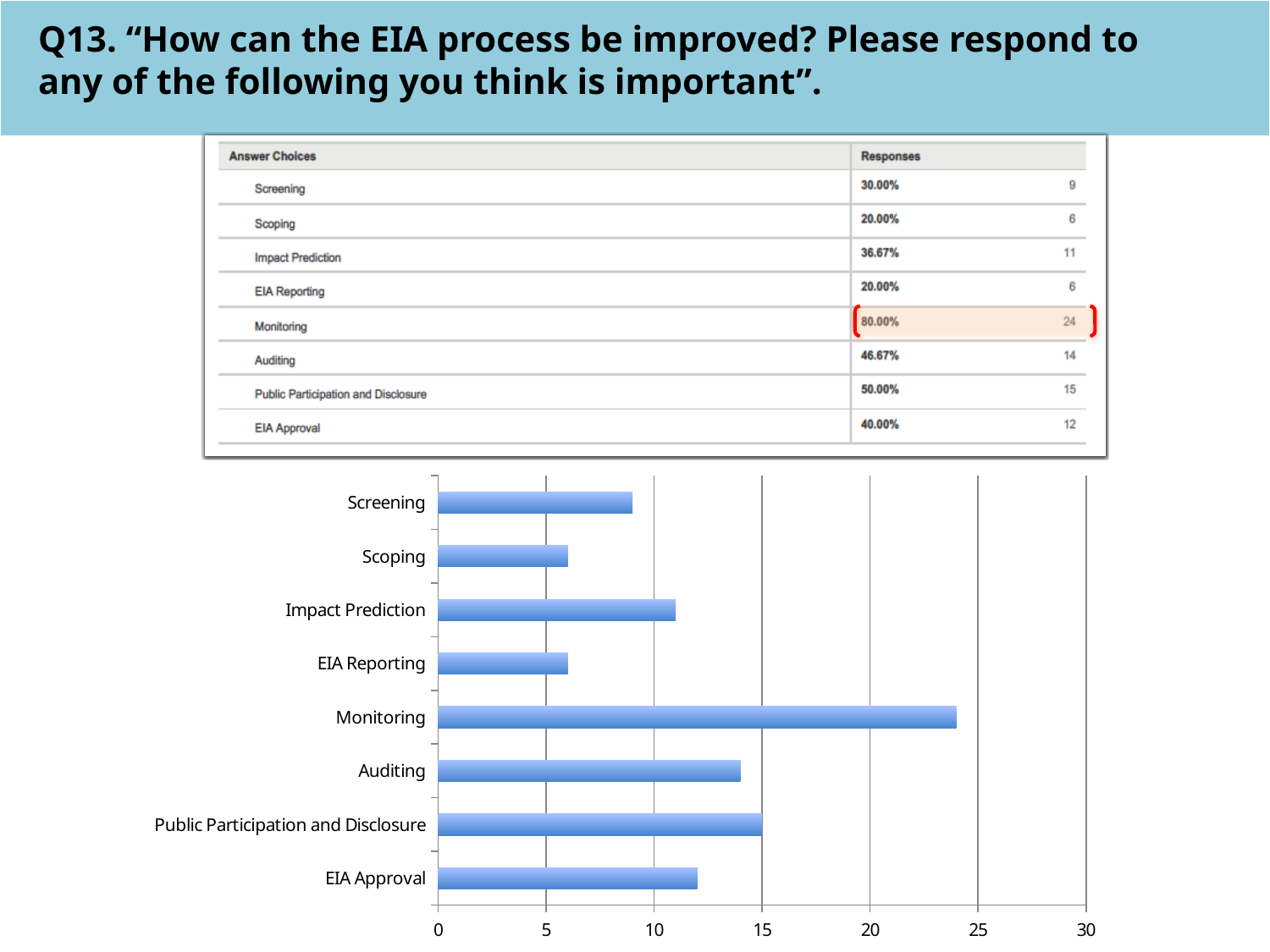
What kind of chart is shown on the slide? bar chart According to the table, what percentage of respondents chose Auditing? 46.67% According to the table, what percentage of respondents chose Public Participation and Disclosure? 50.00% How many answer choices are plotted in the bar chart? 8 Is the bar for Monitoring greater or less than 20? greater According to the table, how many responses did Monitoring receive? 24 Is the bar for Scoping greater or less than 10? less Which answer choice has the highest number of responses in the bar chart? Monitoring Which answer choice is highlighted with red brackets in the table? Monitoring According to the table, how many responses did Impact Prediction receive? 11 Which has more responses in the bar chart, Auditing or Screening? Auditing Using the response counts in the table, how many more responses did Monitoring receive than Public Participation and Disclosure? 9